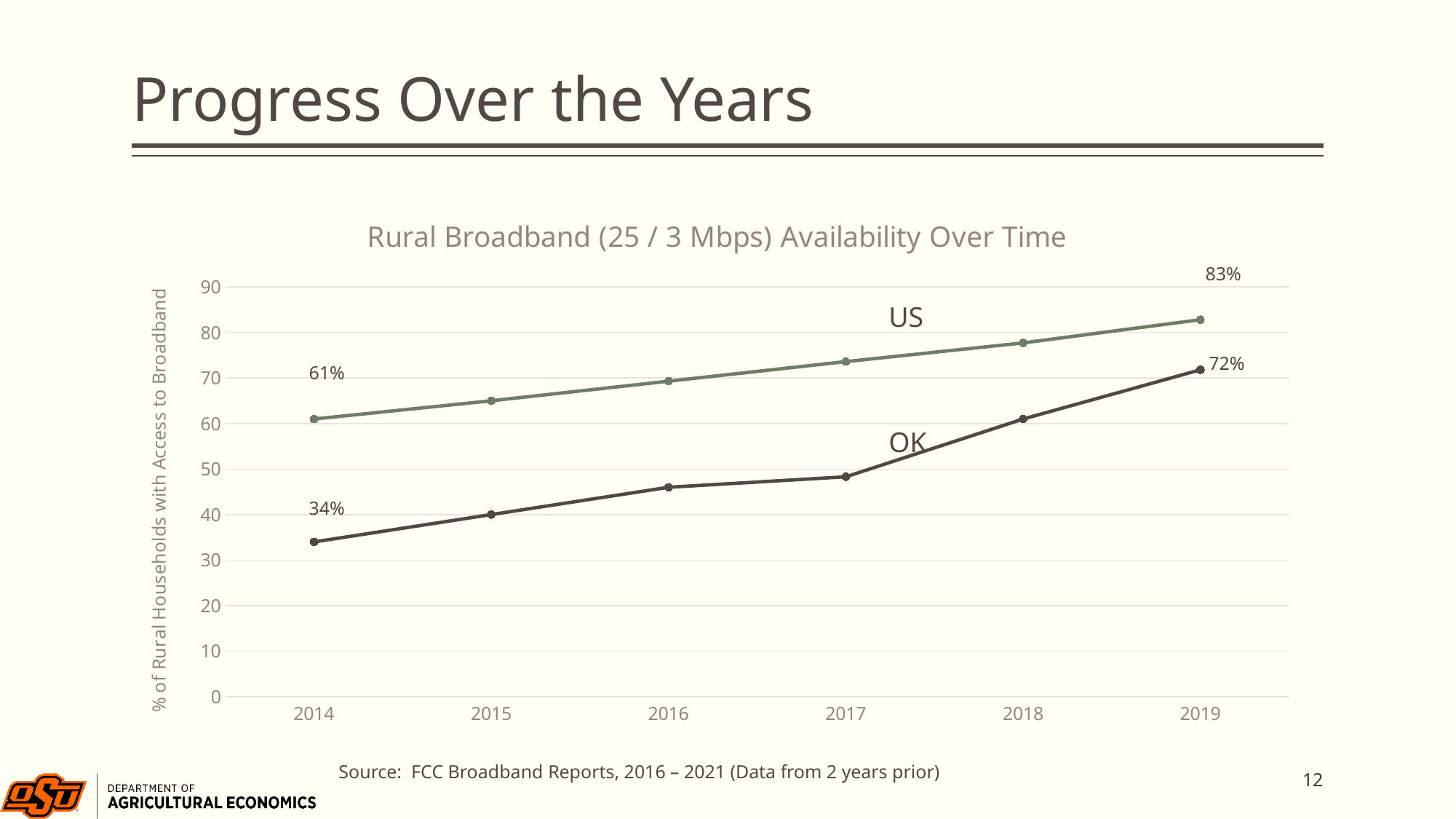
How many years are shown on the x axis? 6 Is the OK value for 2017 greater or less than 50? less What is the OK value for 2019? 72% What is the OK value for 2014? 34% In 2019, which is higher, the US line or the OK line? US By how many percentage points did the OK value increase from 2014 to 2019? 38 percentage points What is the US value for 2019? 83% Does the OK line rise or fall from 2014 to 2019? rise By how many percentage points did the US value increase from 2014 to 2019? 22 percentage points What kind of chart is shown on the slide? line chart What is the US value for 2014? 61% Is the US value for 2016 greater or less than 60? greater